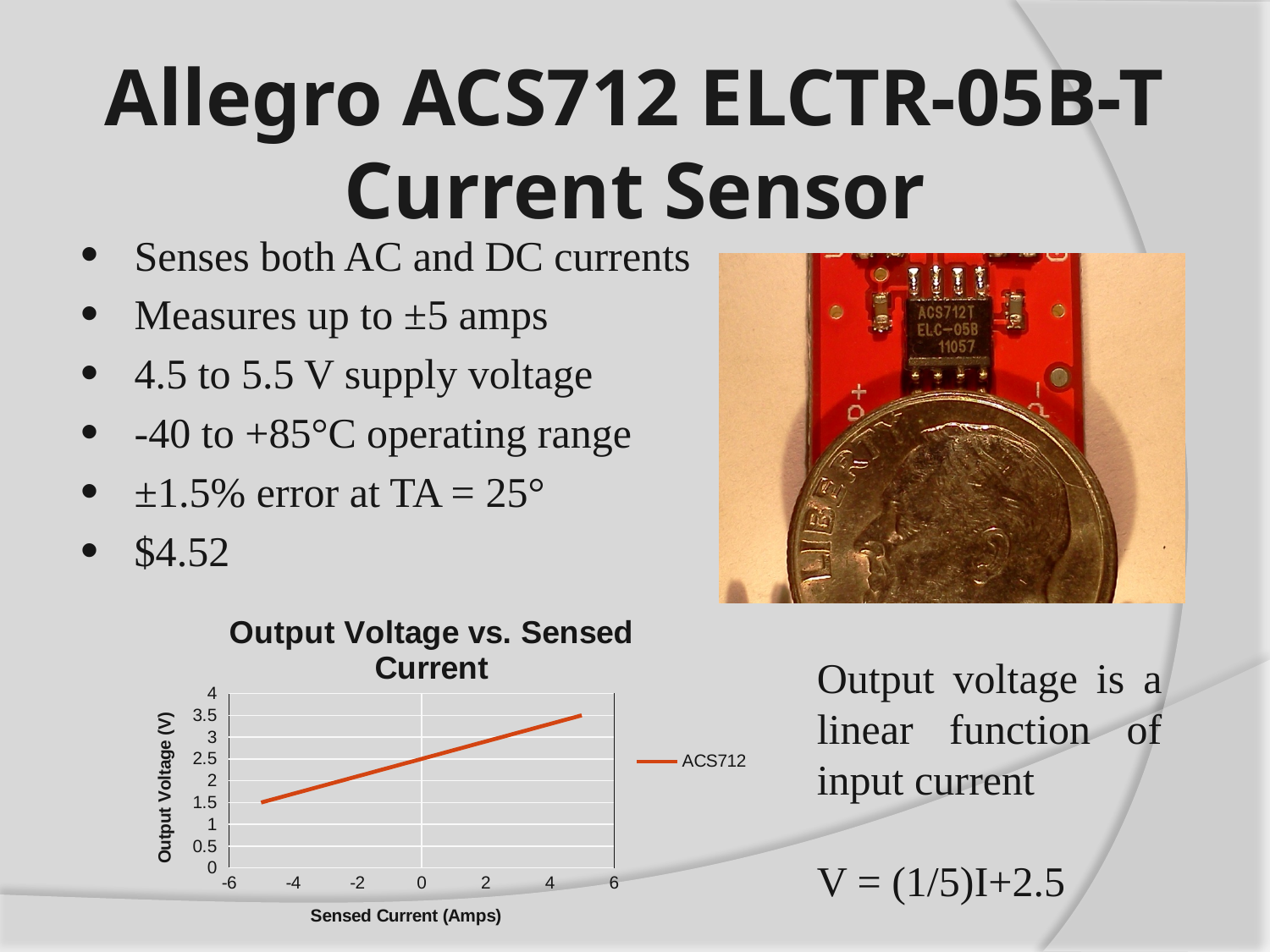
Is the output voltage at a sensed current of 4 amps greater or less than 3? greater What is the name of the series shown in the chart legend? ACS712 What is the title of the chart? Output Voltage vs. Sensed Current How many series does the chart legend list? 1 What kind of chart is shown on the slide? line chart Which is larger, the output voltage at -4 amps or at 4 amps? 4 amps What is the output voltage when the sensed current is 0 amps? 2.5 Does the output voltage rise or fall as the sensed current increases along the x axis? rises Is the output voltage at a sensed current of 2 amps greater or less than 2.5? greater Is the output voltage at a sensed current of -4 amps greater or less than 2? less What is the label of the y axis? Output Voltage (V)